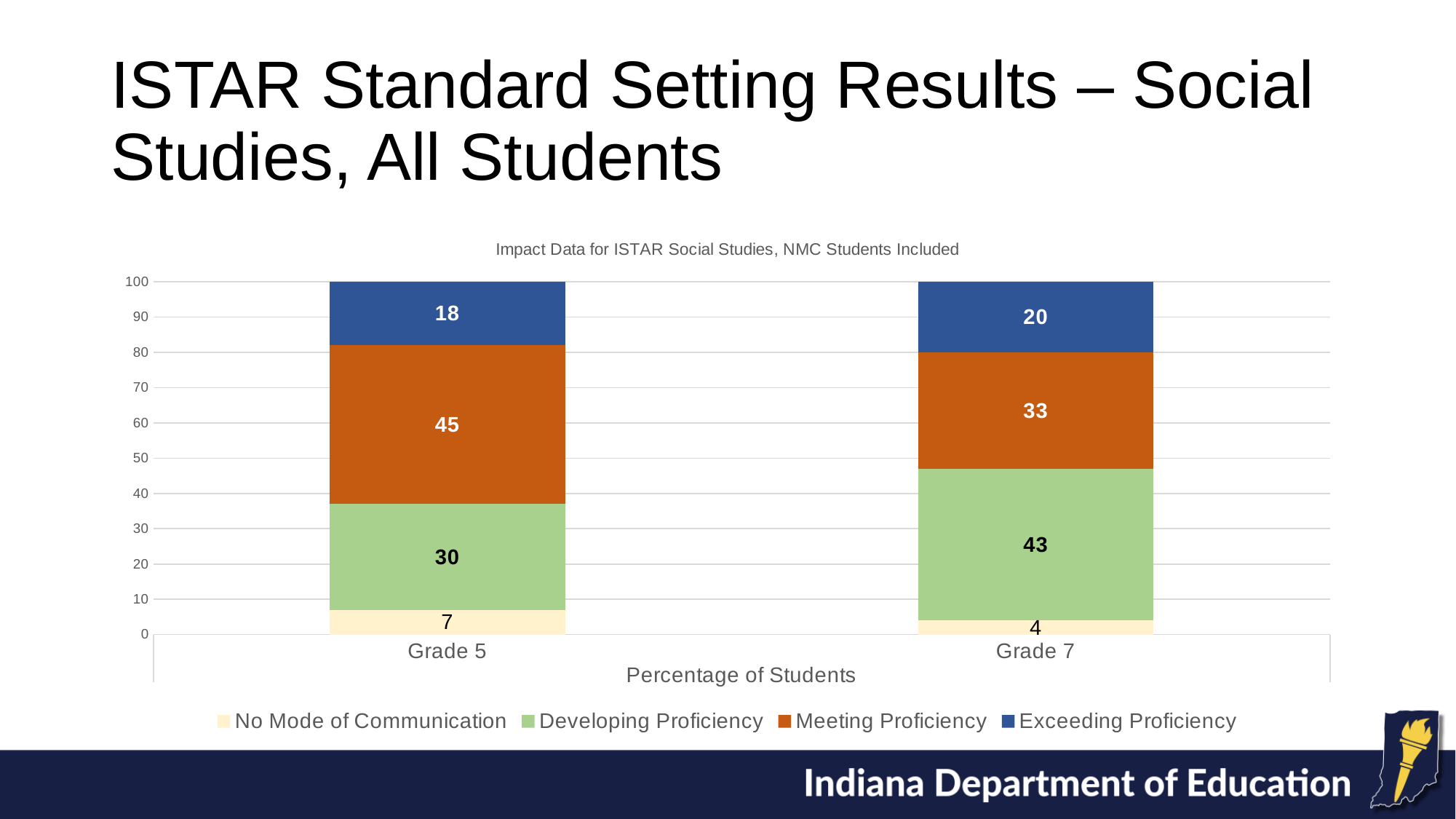
What kind of chart is shown on the slide? Stacked bar chart What is the value for No Mode of Communication in Grade 7? 4 What is the value for Meeting Proficiency in Grade 5? 45 What is the difference between the Developing Proficiency values for Grade 7 and Grade 5? 13 How many categories are shown on the x axis? 2 How many series does the legend list? 4 What is the total of the stacked bar for Grade 5? 100 What is the title of the chart? Impact Data for ISTAR Social Studies, NMC Students Included Which grade has the higher value for Exceeding Proficiency? Grade 7 What is the value for Developing Proficiency in Grade 7? 43 Which grade has the lower value for Meeting Proficiency? Grade 7 What is the value for Exceeding Proficiency in Grade 5? 18